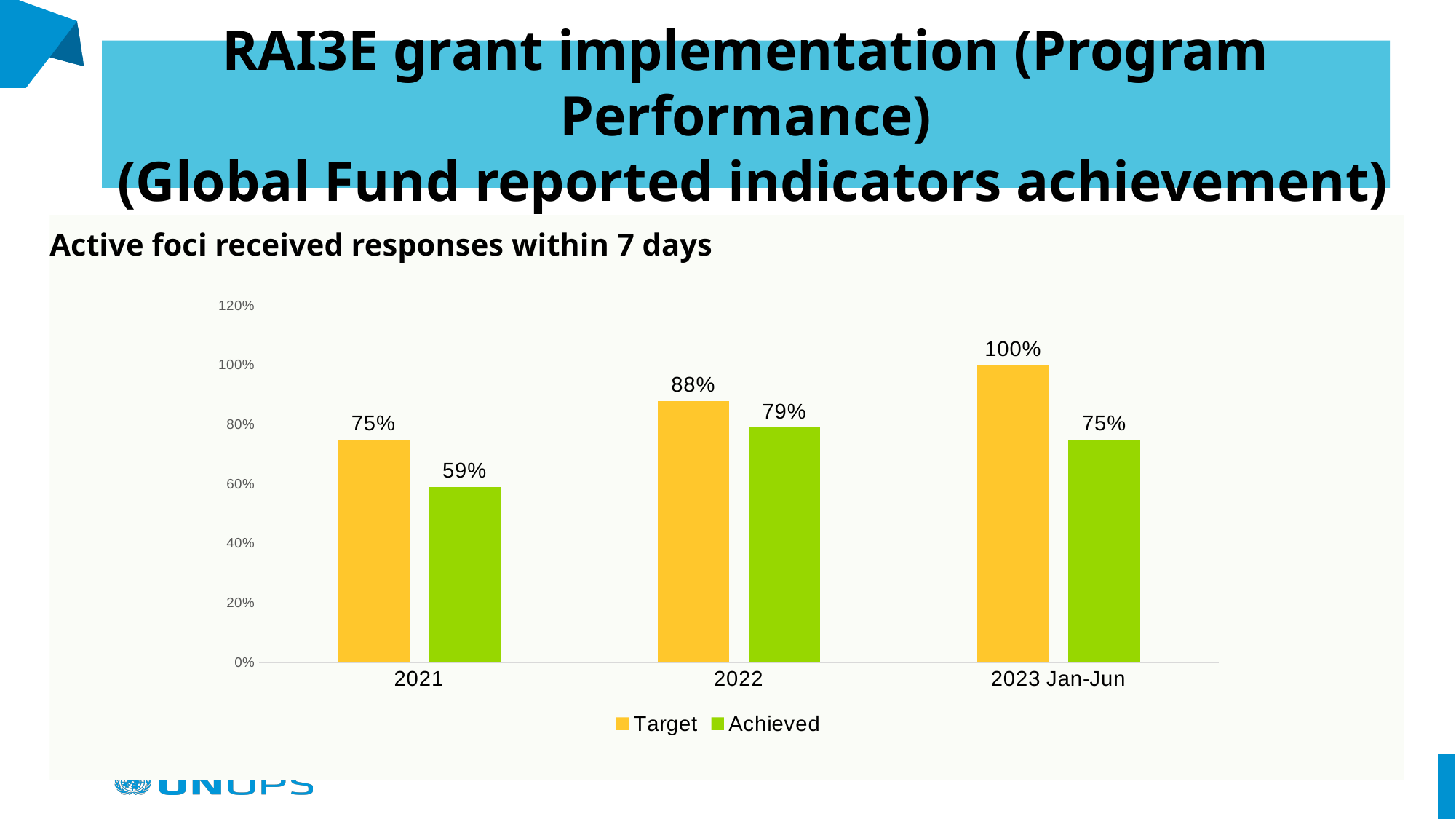
Do the Achieved values rise or fall from 2021 to 2022? Rise Which is larger for 2022, the Target or the Achieved value? Target Which year has the highest Target value? 2023 Jan-Jun What is the Achieved value for 2021? 59% What is the Achieved value for 2022? 79% How many series does the legend list? 2 How many categories are shown on the x axis? 3 What kind of chart is shown on the slide? Bar chart What is the Target value for 2023 Jan-Jun? 100% What is the difference between the Target and Achieved values for 2023 Jan-Jun? 25% What is the Target value for 2021? 75% Which year has the lowest Achieved value? 2021